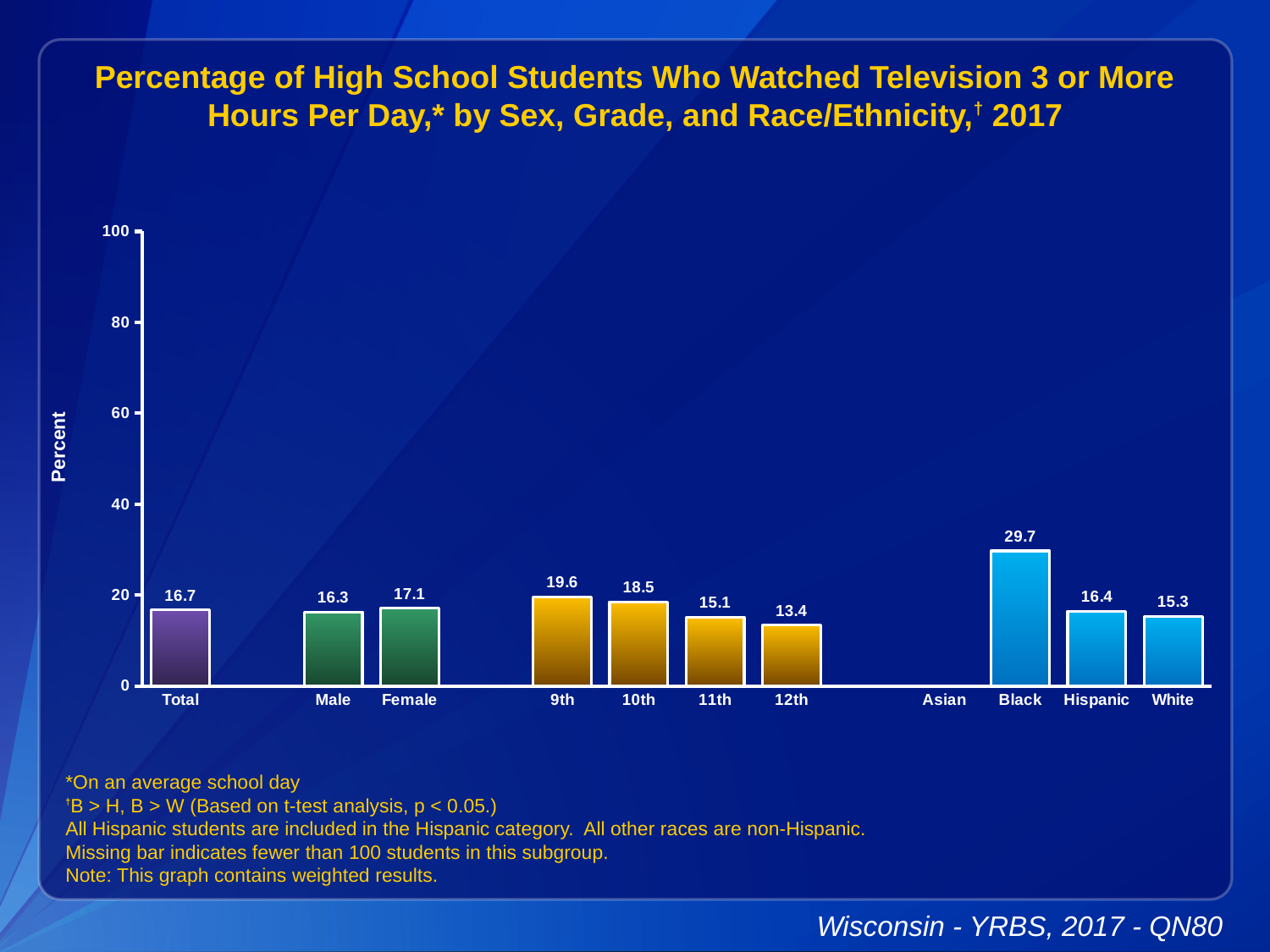
Do the values rise or fall across the grade categories from 9th to 12th? fall What is the value for Black students? 29.7 What kind of chart is shown? bar chart What is the value for Total? 16.7 What is the difference between the 9th grade and 12th grade values? 6.2 Which category has the highest value? Black How many bars are plotted on the chart? 10 Is the value for Black greater or less than 20? greater What is the difference between the Female and Male values? 0.8 Which is larger, the value for Hispanic or the value for White? Hispanic Which category has the lowest value among the bars shown? 12th What is the value for 12th grade? 13.4